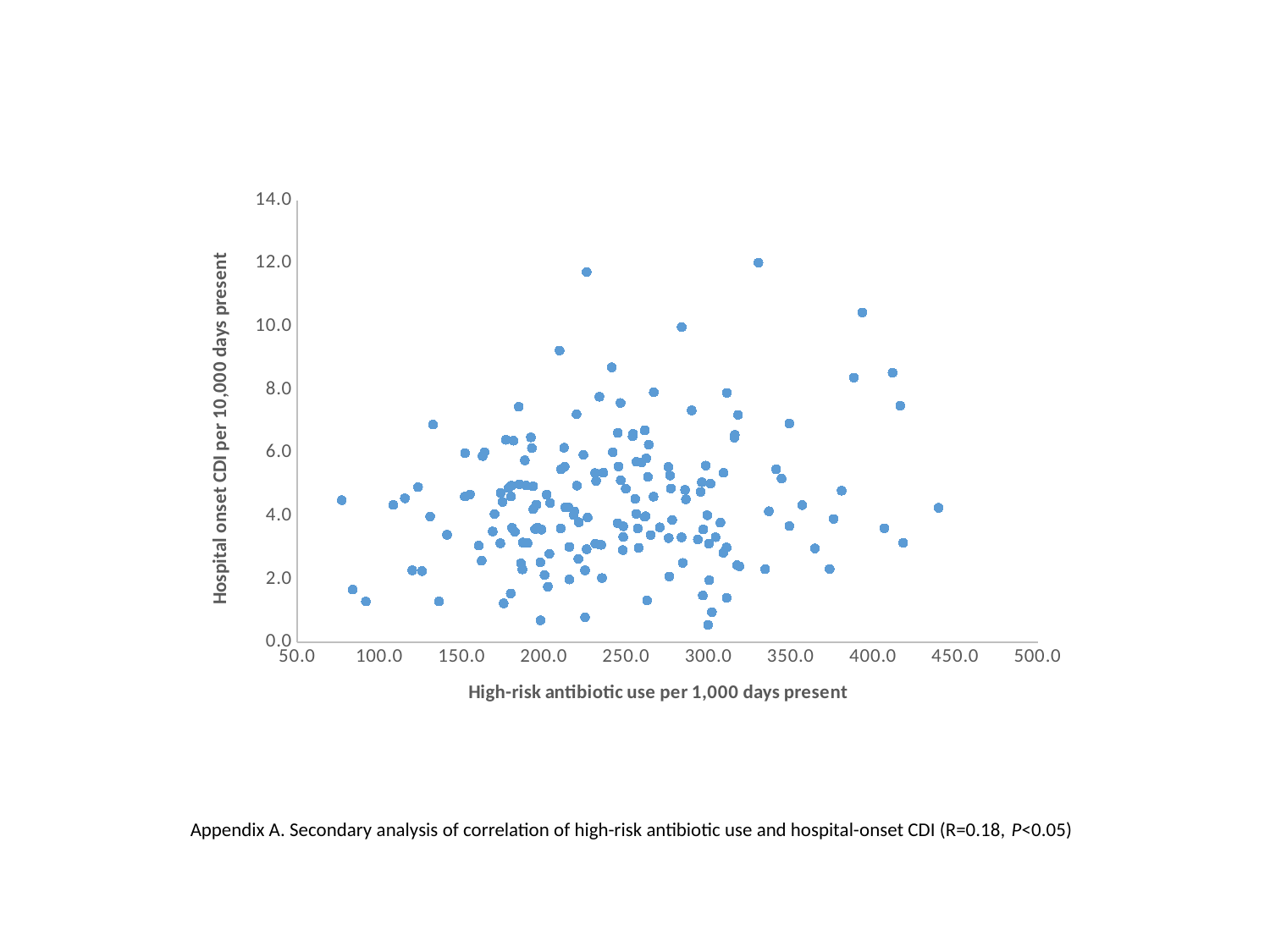
What is the title of the x axis of the chart? High-risk antibiotic use per 1,000 days present Is the y value of the point with the largest x value greater or less than 5.0? less Is the y value of the point with the smallest x value greater or less than 3.0? greater According to the caption, is the correlation between high-risk antibiotic use and hospital-onset CDI positive or negative? positive Is the highest plotted y value on the chart greater or less than 10.0? greater What is the title of the y axis of the chart? Hospital onset CDI per 10,000 days present What kind of chart is shown on the slide? scatter plot